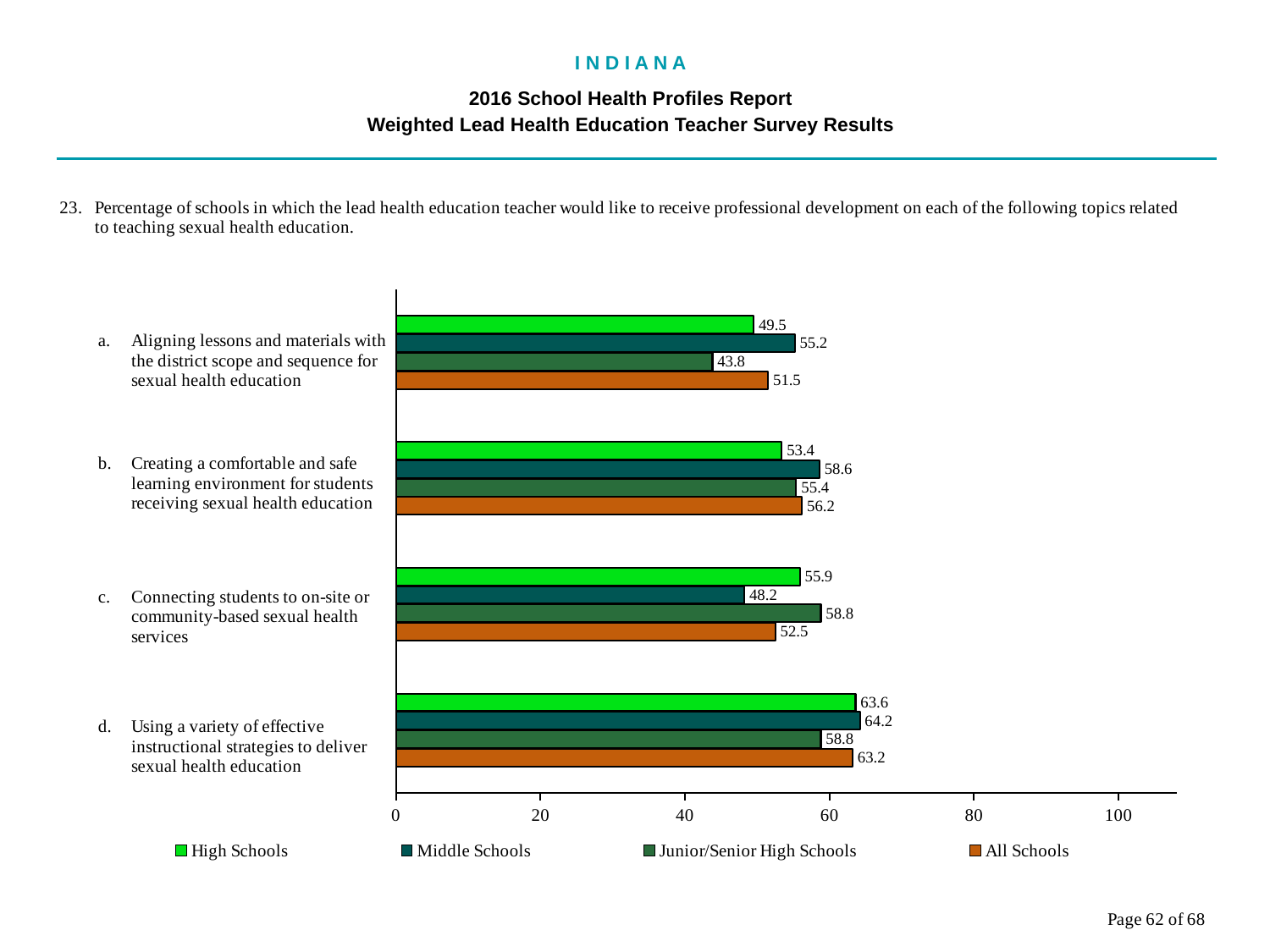
Which school type has the lowest value for topic a, aligning lessons and materials with the district scope and sequence? Junior/Senior High Schools Which topic has the highest value for All Schools? d. Using a variety of effective instructional strategies to deliver sexual health education What is the value for All Schools for topic b, creating a comfortable and safe learning environment for students receiving sexual health education? 56.2 How many series does the legend list? 4 What kind of chart is shown on the slide? Bar chart How many topics are shown on the chart? 4 What is the value for Junior/Senior High Schools for topic c, connecting students to on-site or community-based sexual health services? 58.8 Is the value for Middle Schools for topic d, using a variety of effective instructional strategies, greater or less than 60? greater For topic b, creating a comfortable and safe learning environment, which is larger: the Middle Schools value or the High Schools value? Middle Schools What is the difference between the Middle Schools and High Schools values for topic c, connecting students to on-site or community-based sexual health services? 7.7 What is the value for Middle Schools for topic d, using a variety of effective instructional strategies to deliver sexual health education? 64.2 What is the value for High Schools for topic a, aligning lessons and materials with the district scope and sequence for sexual health education? 49.5